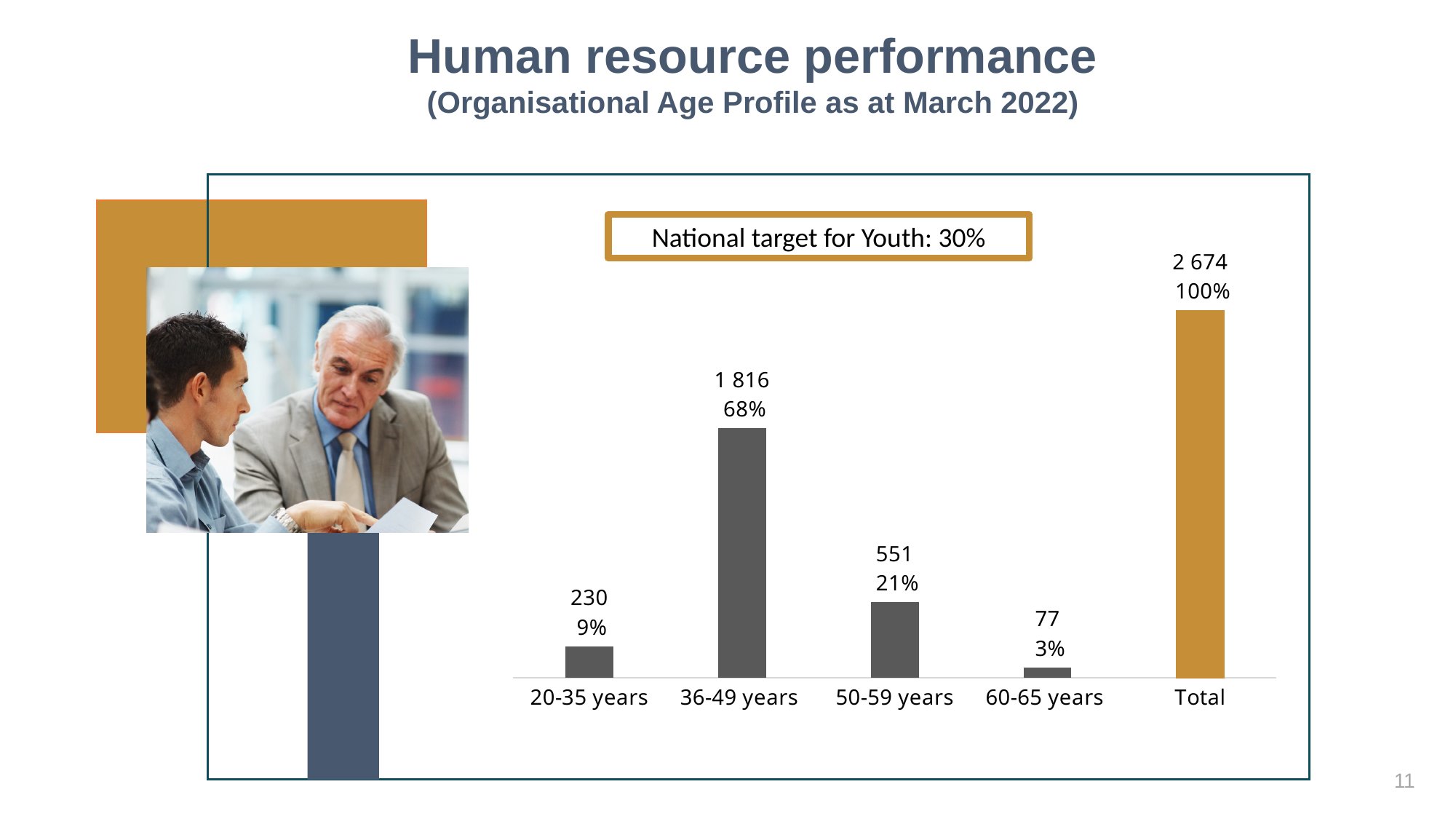
What is the difference between the number of employees in the 36-49 years group and the 50-59 years group? 1 265 What kind of chart is shown on the slide? Bar chart Which age group has the lowest number of employees? 60-65 years How many age group categories are shown in the chart, excluding the Total bar? 4 What is the number of employees in the 36-49 years age group? 1 816 What percentage of the organisation is in the 20-35 years age group? 9% Which age group has more employees, 20-35 years or 50-59 years? 50-59 years Which age group has the highest number of employees? 36-49 years What is the value shown for the 60-65 years age group? 77 What is the total number of employees shown in the chart? 2 674 What is the national target for youth stated on the slide? 30% What colour is the Total bar in the chart? Gold